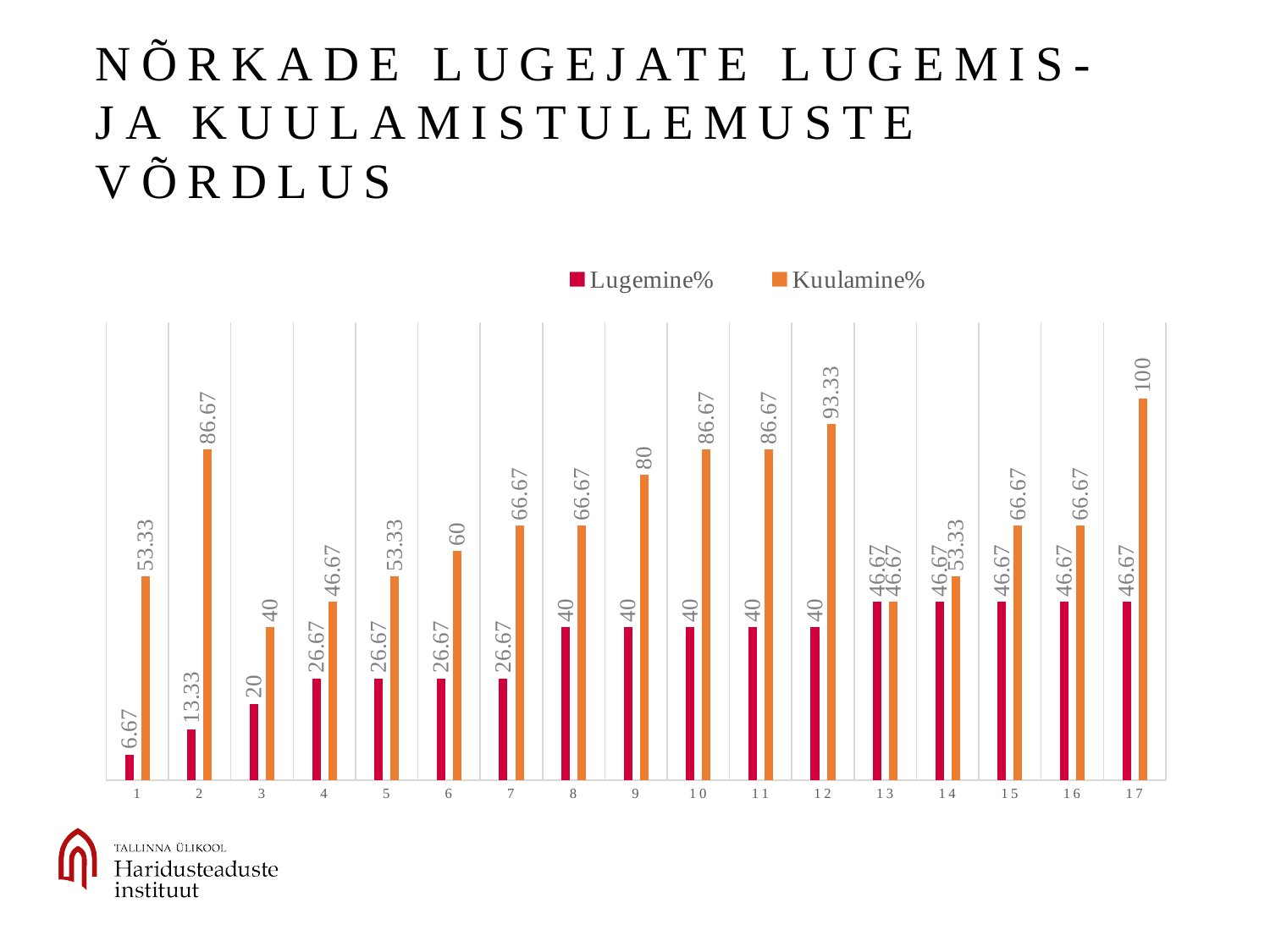
Do the Lugemine% values rise or fall from category 1 to category 17? rise Which category has the lowest Lugemine% value? 1 How many series does the legend list? 2 What is the Kuulamine% value for category 12? 93.33 How many categories are shown on the x axis? 17 What is the Kuulamine% value for category 9? 80 What is the Lugemine% value for category 1? 6.67 What is the difference between the Kuulamine% and Lugemine% values for category 2? 73.34 Which category has the highest Kuulamine% value? 17 Which series is shown in orange in the legend? Kuulamine% What type of chart is shown on the slide? bar chart For category 3, which is larger: Lugemine% or Kuulamine%? Kuulamine%